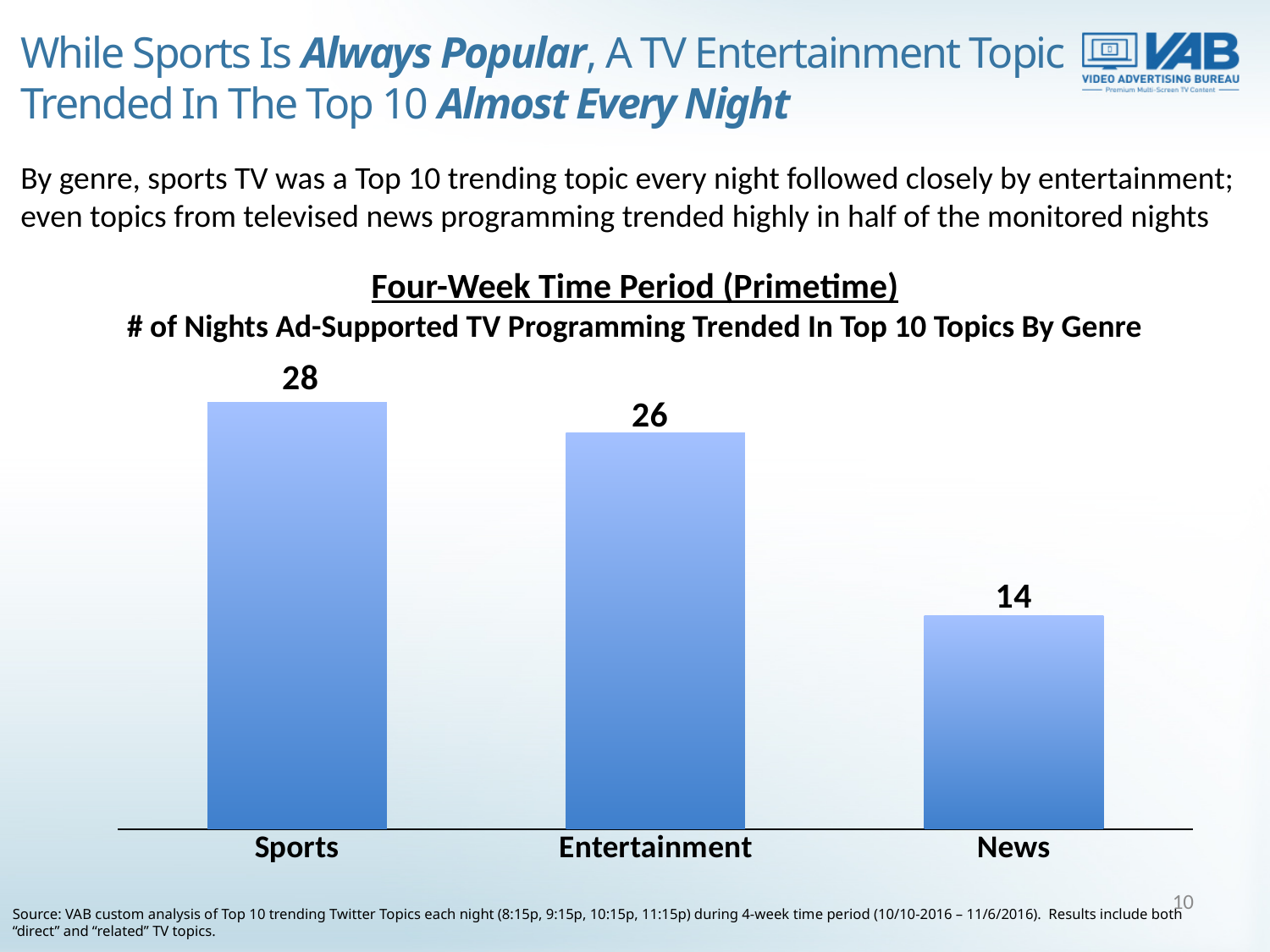
How many nights did Sports trend in the Top 10 topics? 28 Which genre has the lowest number of nights trending in the Top 10? News Which genre has the highest number of nights trending in the Top 10? Sports What is the difference in nights between Sports and News? 14 How many genres are shown in the chart? 3 What is the difference in nights between Sports and Entertainment? 2 What time period does the chart title say the data covers? Four-Week Time Period (Primetime) Do the values rise or fall moving from left to right across the genres? Fall Which has more nights trending in the Top 10, Entertainment or News? Entertainment What kind of chart is shown on the slide? Bar chart How many nights did Entertainment trend in the Top 10 topics? 26 How many nights did News trend in the Top 10 topics? 14